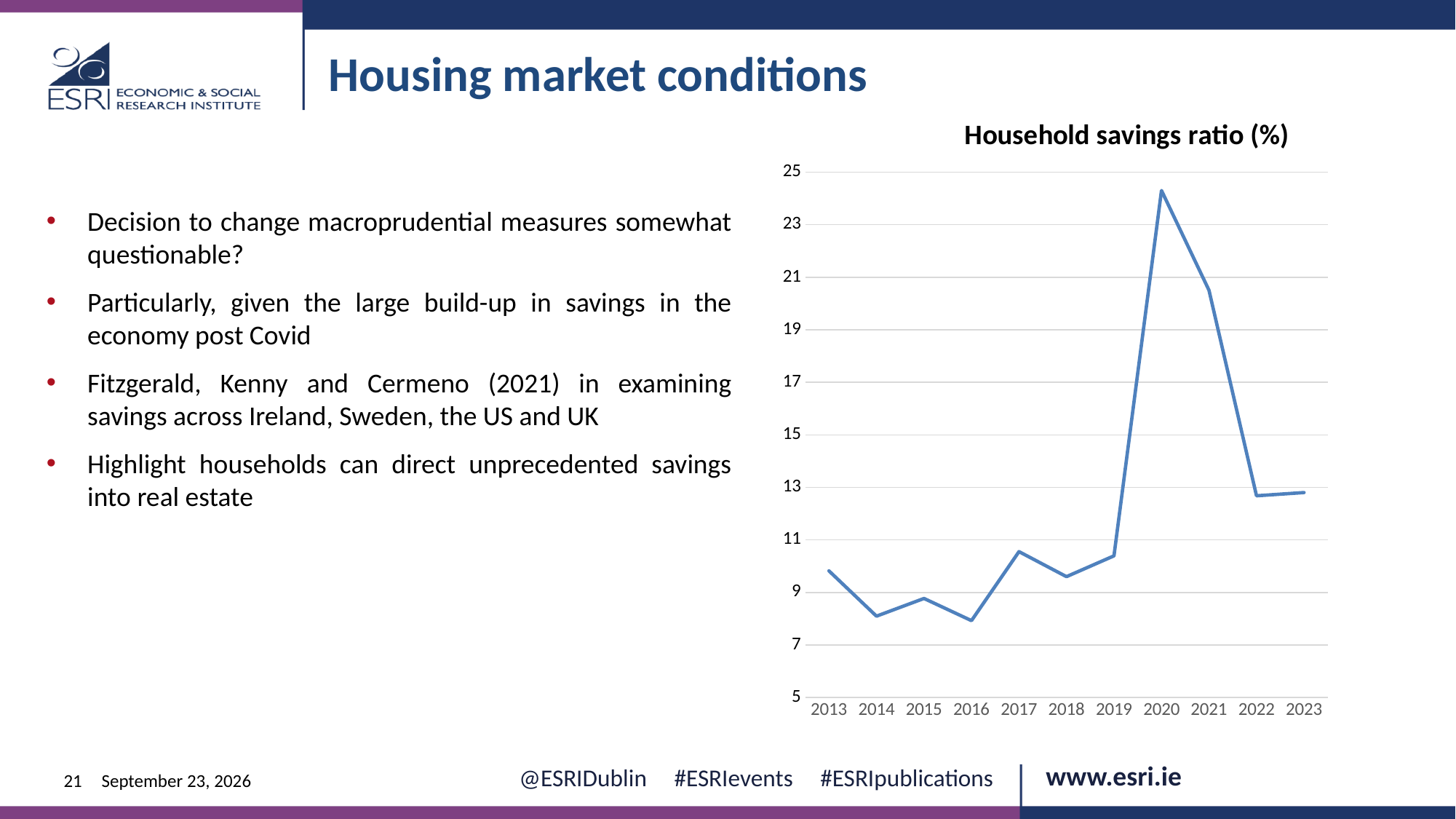
How many years are plotted on the x axis of the chart? 11 Is the household savings ratio for 2020 greater or less than 23? greater Is the household savings ratio for 2022 greater or less than 13? less Is the household savings ratio for 2016 greater or less than 9? less What is the title of the chart? Household savings ratio (%) What kind of chart is shown on the slide? line chart Which year has the higher household savings ratio, 2020 or 2021? 2020 Does the household savings ratio rise or fall from 2020 to 2022? fall Which year has the higher household savings ratio, 2013 or 2014? 2013 In which year is the household savings ratio highest? 2020